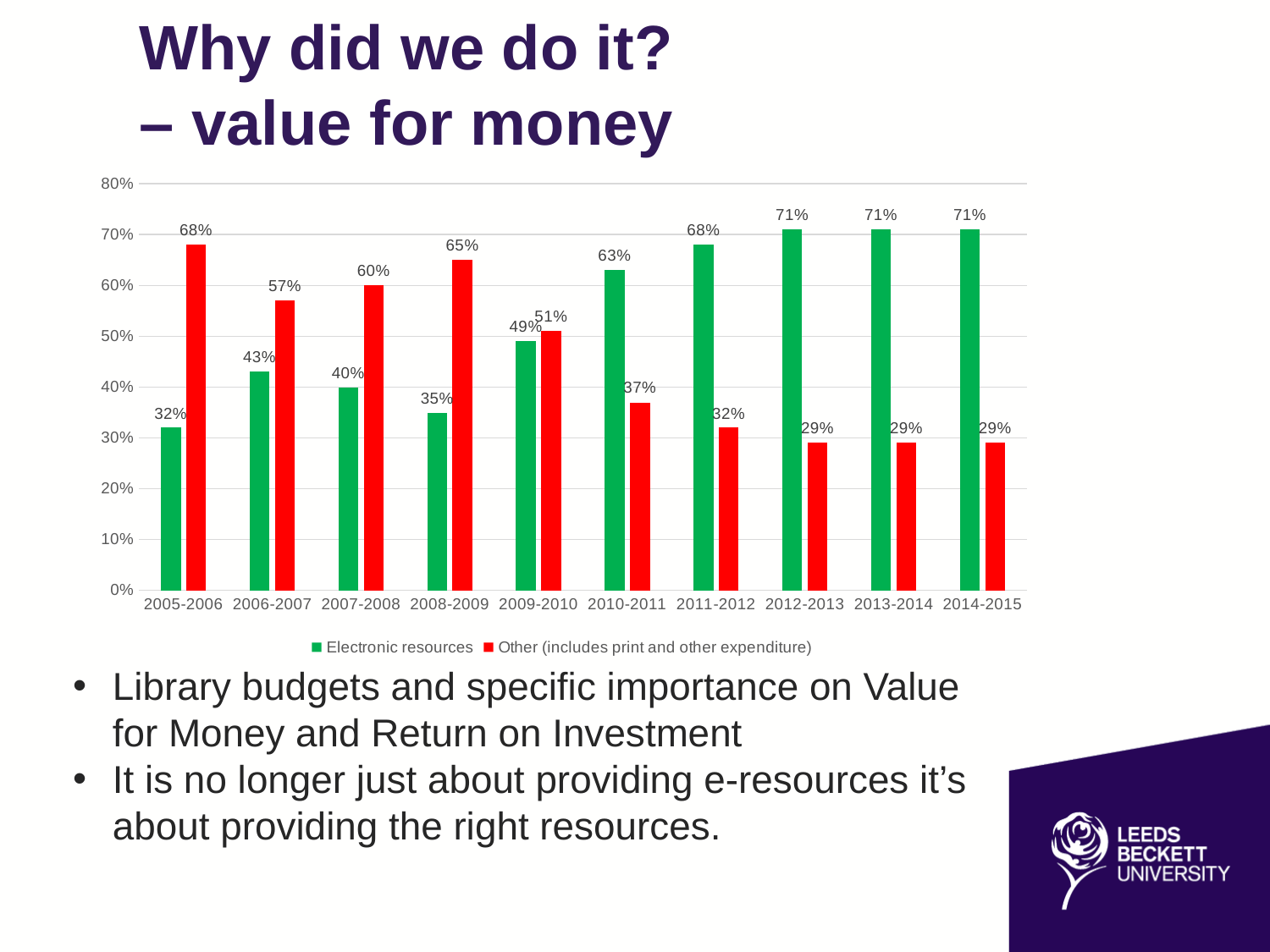
What is the value for Electronic resources in 2010-2011? 63% What is the difference between Electronic resources and Other in 2014-2015? 42% What is the value for Other (includes print and other expenditure) in 2008-2009? 65% What kind of chart is shown on the slide? Bar chart How many series does the legend list? 2 In 2009-2010, which series has the larger value, Electronic resources or Other? Other (includes print and other expenditure) What is the value for Electronic resources in 2005-2006? 32% In which year is the Electronic resources value lowest? 2005-2006 In which year does Other (includes print and other expenditure) reach its highest value? 2005-2006 Do the Electronic resources values generally rise or fall from 2005-2006 to 2014-2015? Rise What colour are the bars for Electronic resources? Green How many year categories are shown on the x axis? 10